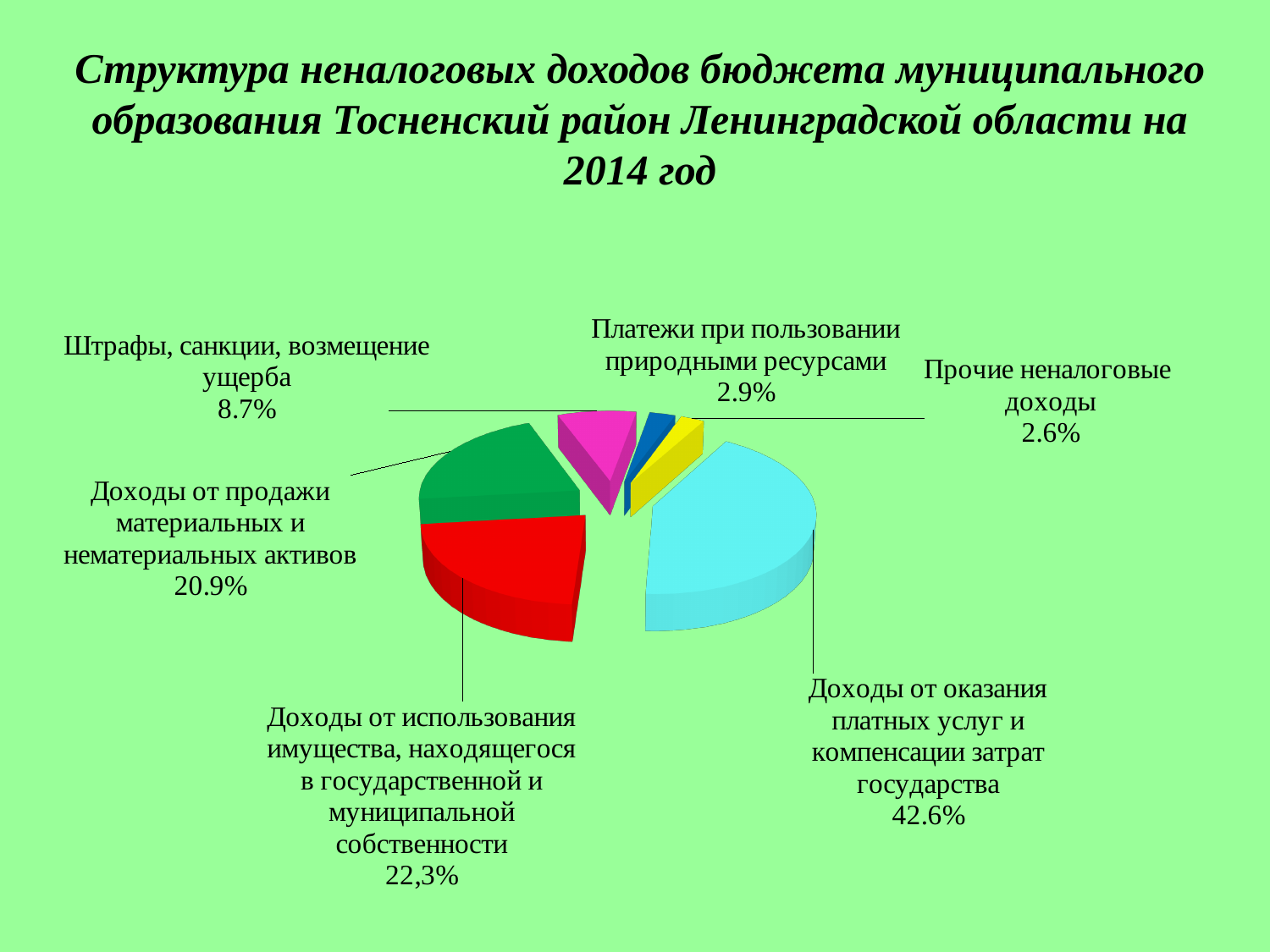
What value is labelled for "Доходы от использования имущества, находящегося в государственной и муниципальной собственности"? 22,3% What percentage is shown for "Штрафы, санкции, возмещение ущерба"? 8.7% What colour is the slice for "Доходы от оказания платных услуг и компенсации затрат государства"? Light blue What is the difference between "Платежи при пользовании природными ресурсами" and "Прочие неналоговые доходы"? 0.3% What type of chart is shown on the slide? Pie chart What share of the pie does "Доходы от оказания платных услуг и компенсации затрат государства" represent? 42.6% What is the difference in percentage points between "Доходы от продажи материальных и нематериальных активов" and "Штрафы, санкции, возмещение ущерба"? 12.2% Which category has the largest slice of the pie? Доходы от оказания платных услуг и компенсации затрат государства How many categories (slices) does the pie chart have? 6 What percentage is shown for "Платежи при пользовании природными ресурсами"? 2.9% Which is larger: "Платежи при пользовании природными ресурсами" or "Прочие неналоговые доходы"? Платежи при пользовании природными ресурсами Which category has the smallest slice of the pie? Прочие неналоговые доходы